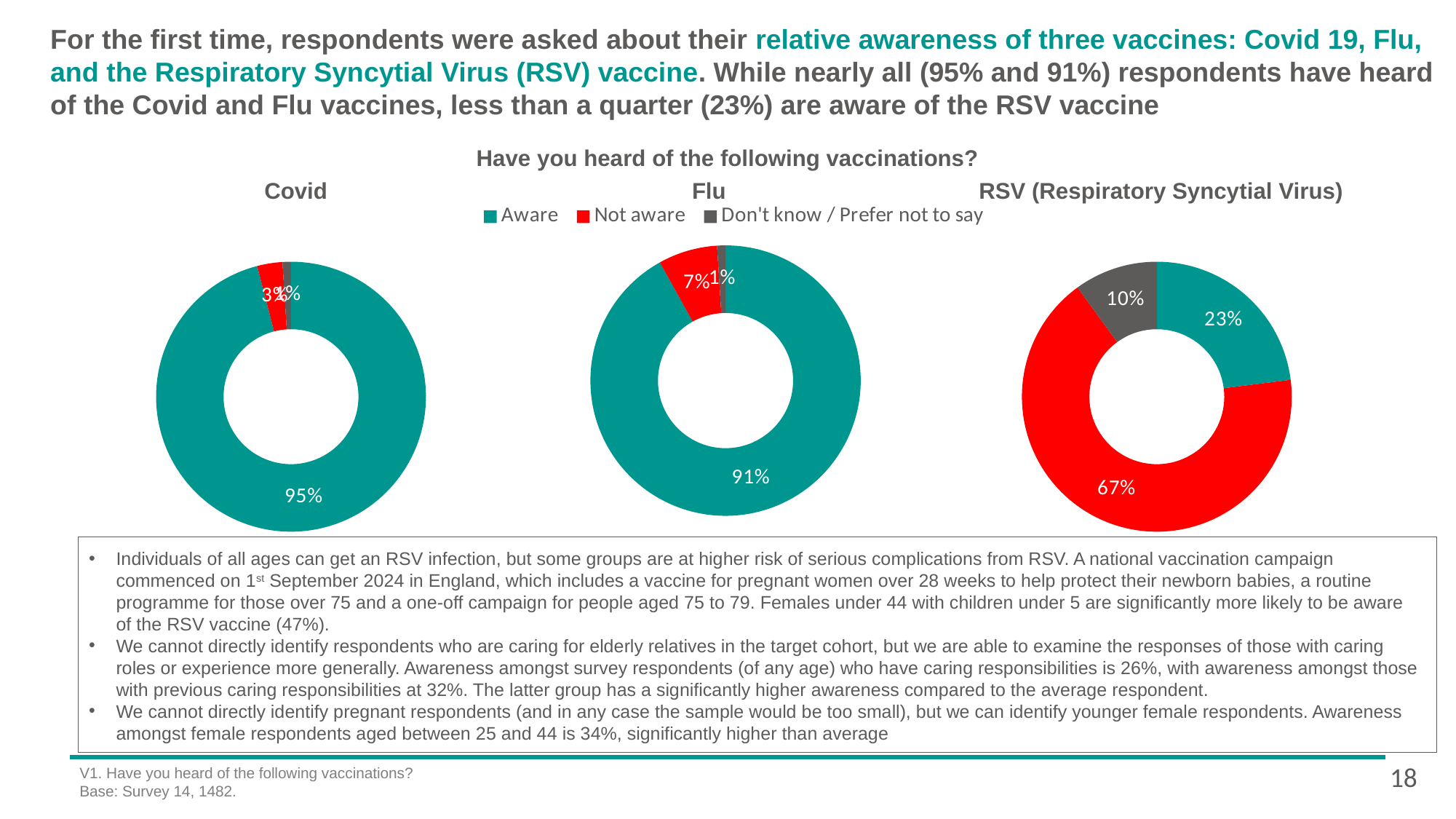
In the RSV (Respiratory Syncytial Virus) chart, which category has the smallest share? Don't know / Prefer not to say In the RSV (Respiratory Syncytial Virus) chart, what percentage answered Don't know / Prefer not to say? 10% How many series does the legend list for these charts? 3 What type of chart is used to show awareness of each vaccine? Donut (pie) chart Which chart shows a higher Aware share, Covid or Flu? Covid In the Covid chart, what percentage of respondents are aware of the vaccine? 95% In the RSV (Respiratory Syncytial Virus) chart, what percentage of respondents are aware of the vaccine? 23% In the RSV (Respiratory Syncytial Virus) chart, which category has the largest share? Not aware In the Flu chart, what percentage of respondents are aware of the vaccine? 91% In the Flu chart, what percentage of respondents are not aware of the vaccine? 7% In the RSV (Respiratory Syncytial Virus) chart, what percentage of respondents are not aware of the vaccine? 67% What is the difference between the Aware share in the Covid chart and the Aware share in the RSV (Respiratory Syncytial Virus) chart? 72 percentage points